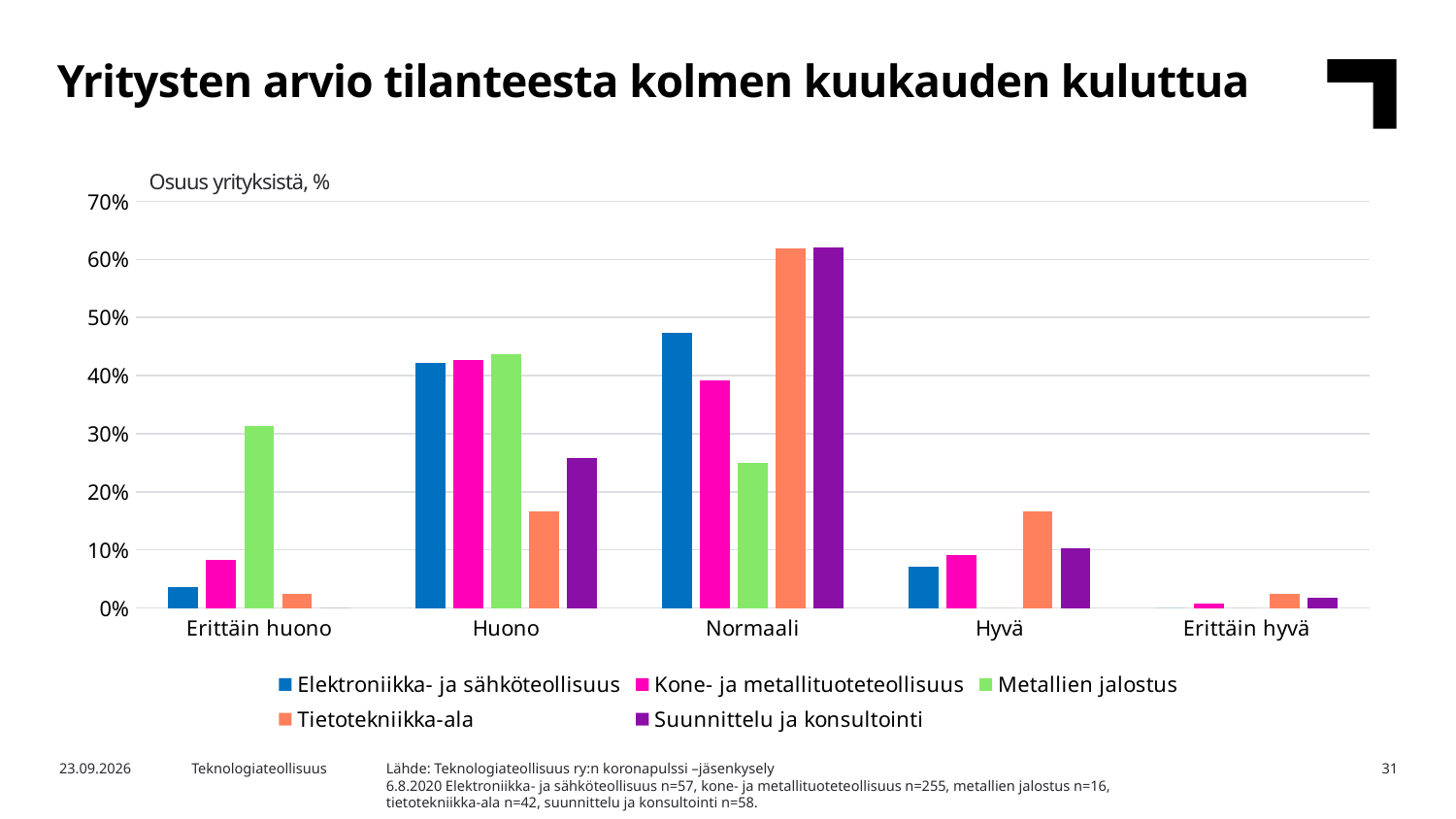
Is the value for Tietotekniikka-ala in the Huono category greater or less than 20%? less What is the label shown above the y axis? Osuus yrityksistä, % Which series has the highest value in the Erittäin huono category? Metallien jalostus How many categories are shown on the x axis? 5 Is the value for Tietotekniikka-ala in the Normaali category greater or less than 50%? greater What kind of chart is shown on the slide? bar chart In the Normaali category, which is larger: Elektroniikka- ja sähköteollisuus or Kone- ja metallituoteteollisuus? Elektroniikka- ja sähköteollisuus How many series does the legend list? 5 Is the value for Metallien jalostus in the Erittäin huono category greater or less than 20%? greater For Elektroniikka- ja sähköteollisuus, which category has the highest value? Normaali For Tietotekniikka-ala, which category has the highest value? Normaali Which series has the lowest value in the Huono category? Tietotekniikka-ala